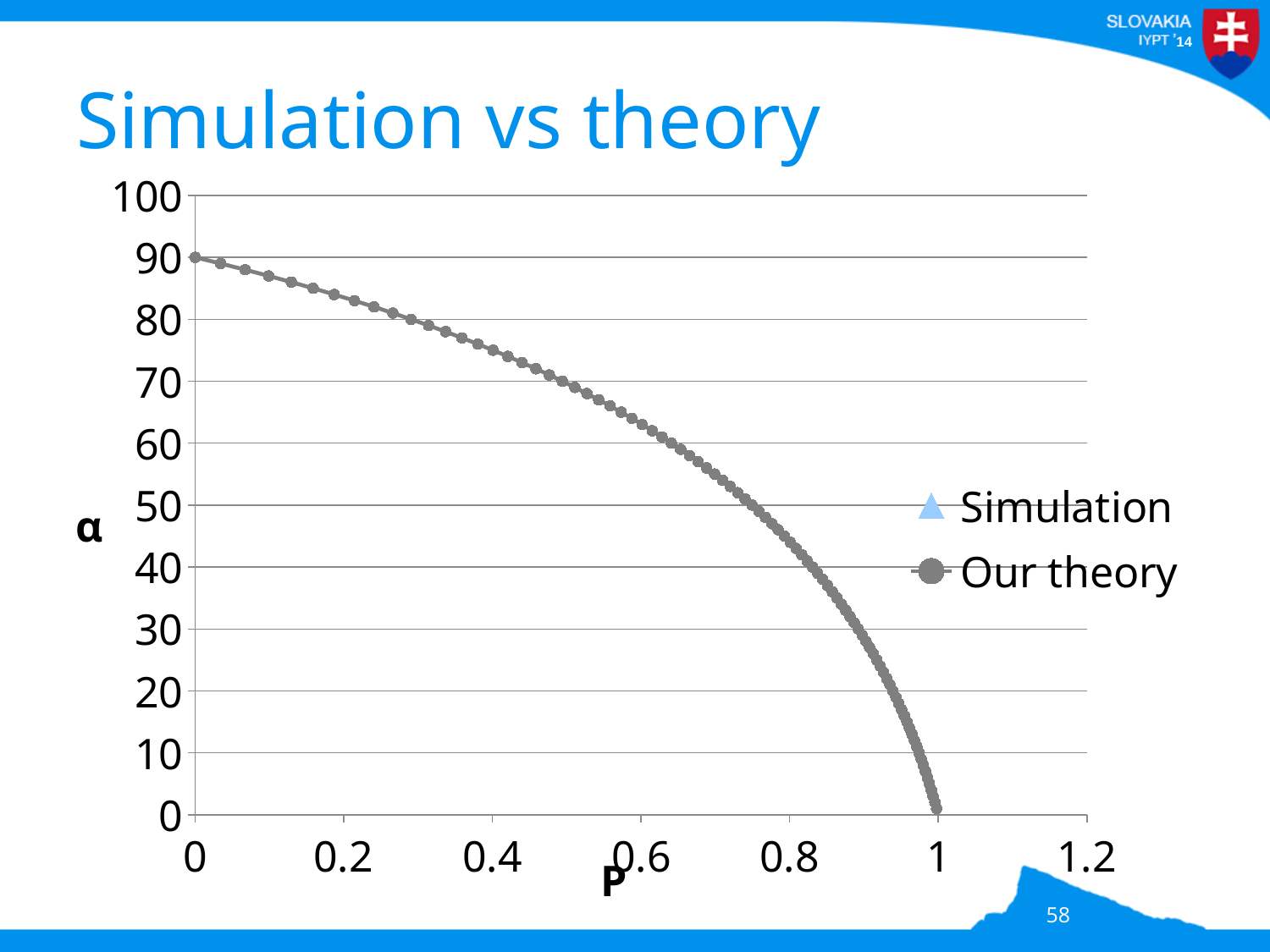
Is the value of α at P = 0.2 greater or less than 80? greater Does α rise or fall as P increases along the x axis? fall What are the two series named in the legend? Simulation and Our theory What is the title of the chart? Simulation vs theory At which value of P is α highest? 0 Is the value of α at P = 0.8 greater or less than 50? less What kind of chart is shown on the slide? scatter chart At which value of P is α lowest? 1 How many series does the legend list? 2 What is the value of α for the Our theory series at P = 0? 90 Is the value of α at P = 0.4 greater or less than 70? greater